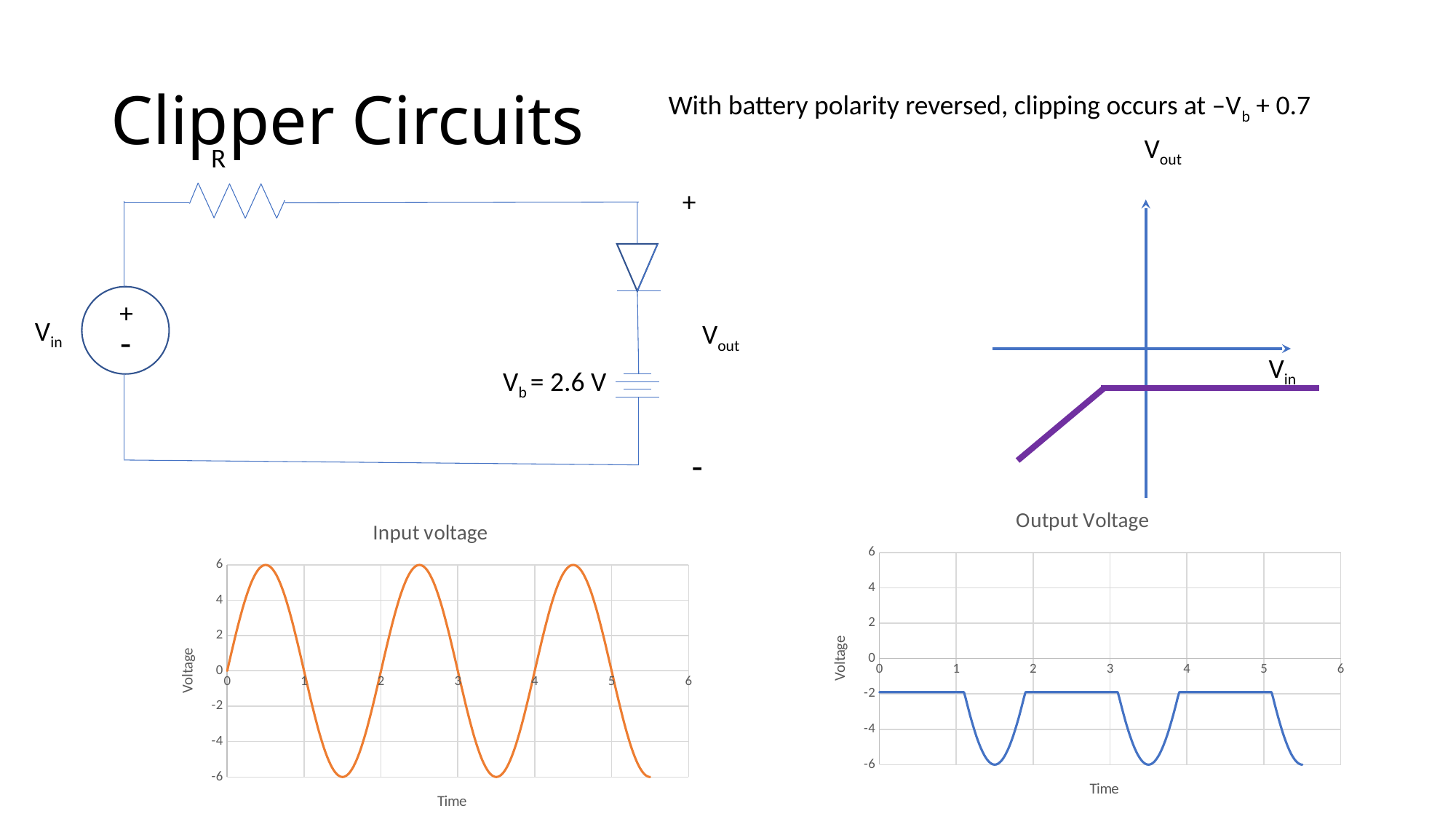
In the "Input voltage" chart, is the voltage at time 0.5 greater or less than 4? greater In the "Input voltage" chart, what is the peak (maximum) voltage reached by the waveform? 6 In the "Input voltage" chart, how many positive peaks does the waveform show? 3 What is the x-axis title of the "Output Voltage" chart? Time Which chart reaches a higher maximum voltage, "Input voltage" or "Output Voltage"? Input voltage In the "Output Voltage" chart, is the voltage at time 1.5 greater or less than -4? less In the "Input voltage" chart, what is the voltage at time 0? 0 What kind of chart is the "Output Voltage" chart? line chart What kind of chart is the "Input voltage" chart? line chart In the "Input voltage" chart, what is the minimum voltage reached by the waveform? -6 In the "Output Voltage" chart, what is the minimum voltage reached by the waveform? -6